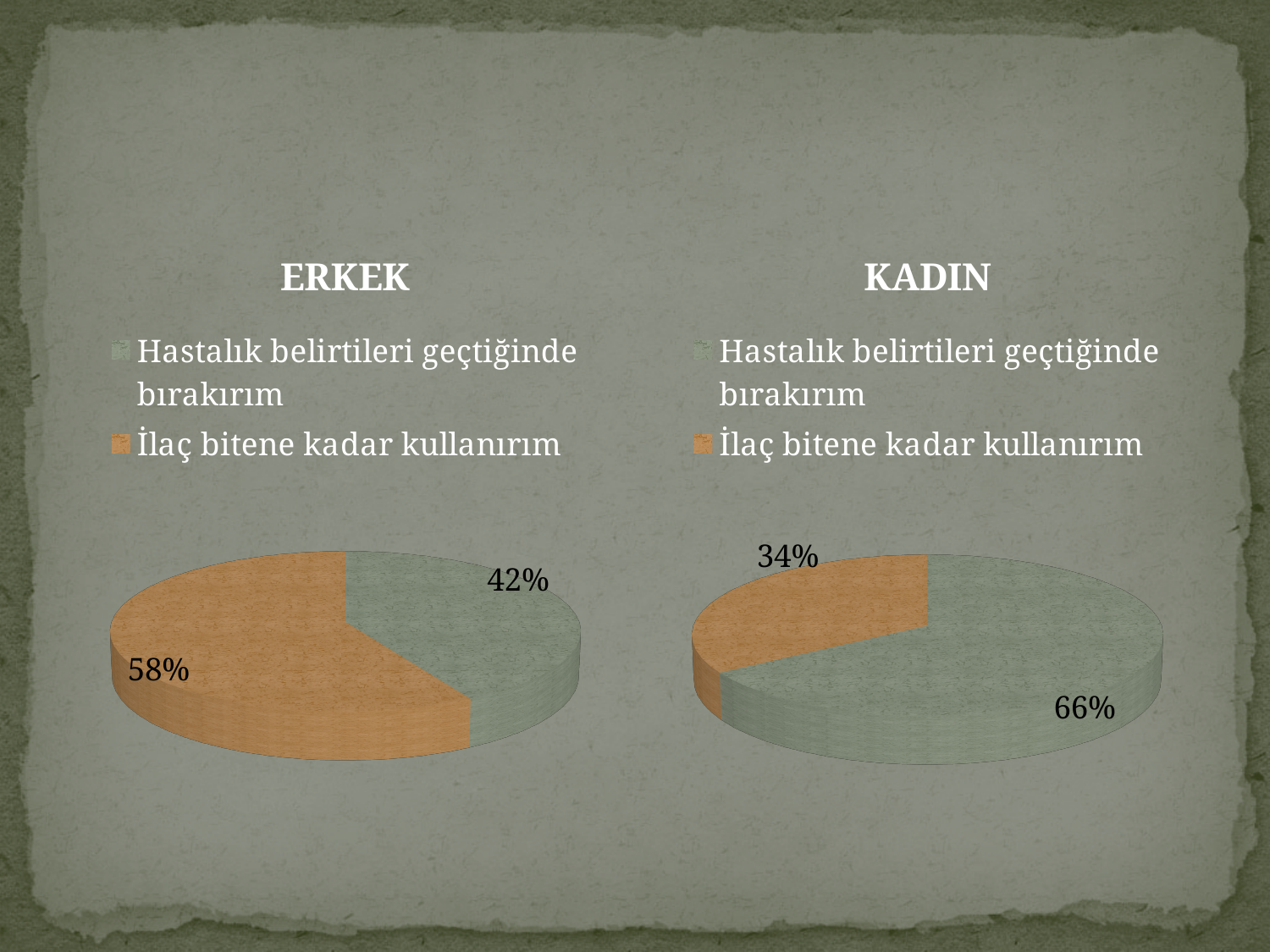
Which is larger: the 'İlaç bitene kadar kullanırım' share in the ERKEK chart or in the KADIN chart? ERKEK In the KADIN chart, which slice is the smallest? İlaç bitene kadar kullanırım In the KADIN chart, what share is labelled for the 'Hastalık belirtileri geçtiğinde bırakırım' slice? 66% How many entries does the legend of the ERKEK chart list? 2 What type of chart is the ERKEK chart? Pie chart How many slices does the KADIN chart have? 2 In the ERKEK chart, what share is labelled for the 'İlaç bitene kadar kullanırım' slice? 58% In the ERKEK chart, what share is labelled for the 'Hastalık belirtileri geçtiğinde bırakırım' slice? 42% In the ERKEK chart, what is the difference in percentage points between the two slices? 16 In the KADIN chart, what share is labelled for the 'İlaç bitene kadar kullanırım' slice? 34% In the KADIN chart, what is the difference in percentage points between the two slices? 32 In the ERKEK chart, which slice is the largest? İlaç bitene kadar kullanırım